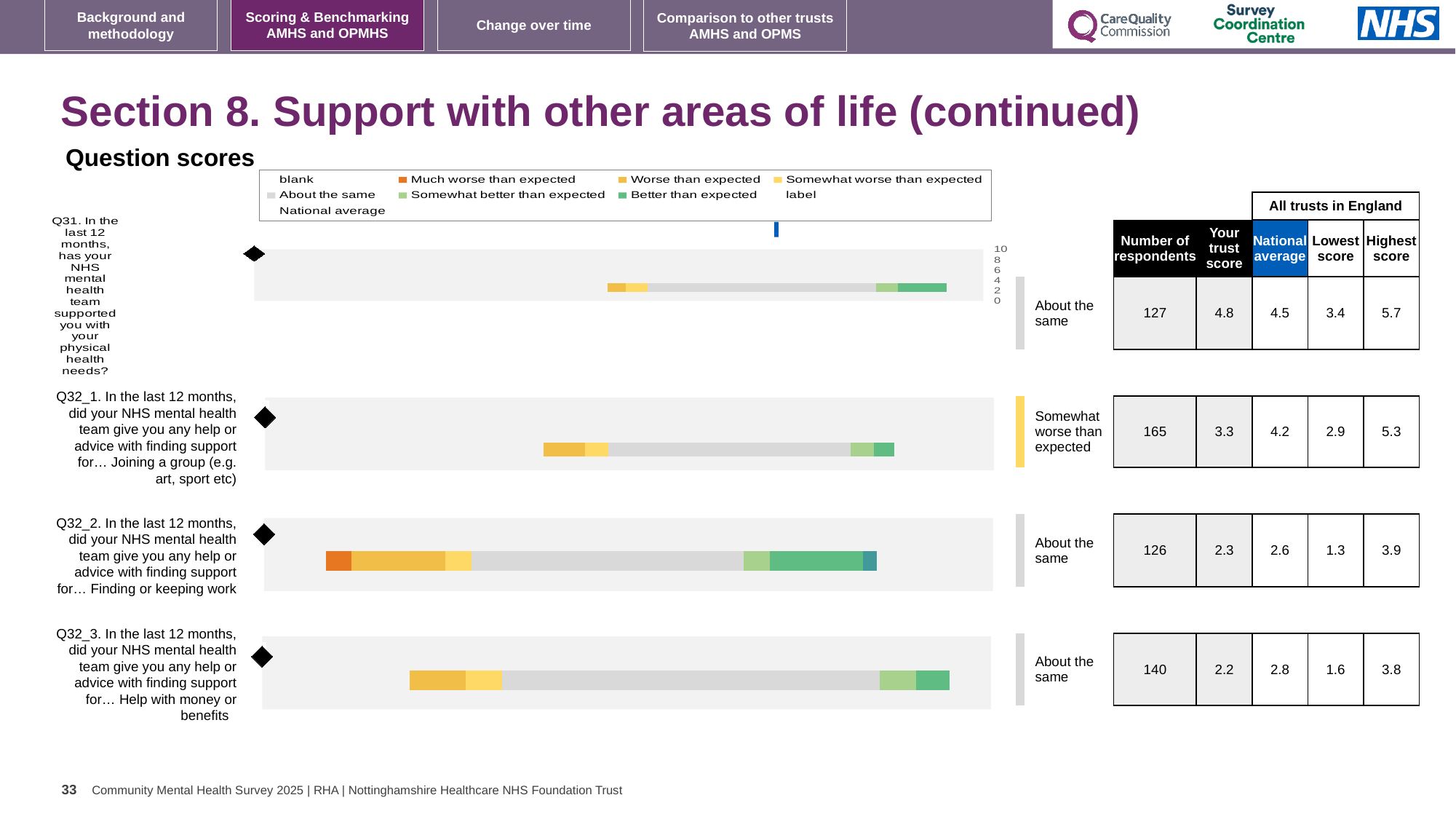
Which question has the highest trust score on this slide? Q31 (4.8) For Q31, which is larger: the trust's score or the national average? the trust's score (4.8) For Q32_1 (help with joining a group), which benchmark category is the trust's score placed in? Somewhat worse than expected For Q32_3 (help with money or benefits), what is the national average score? 2.8 For Q32_1, what is the difference between the national average (4.2) and the trust's score (3.3)? 0.9 What kind of chart is used to show the question scores on this slide? bar chart How many questions (bars) are plotted in the question scores charts on this slide? 4 In the question scores chart legend, which category is shown in orange? Much worse than expected Which question has the lowest trust score on this slide? Q32_3 (2.2) For Q32_2 (help with finding or keeping work), how many respondents are there? 126 In the question scores chart legend, which category is shown in dark green? Better than expected For Q31 (support with physical health needs), what is the trust's score? 4.8